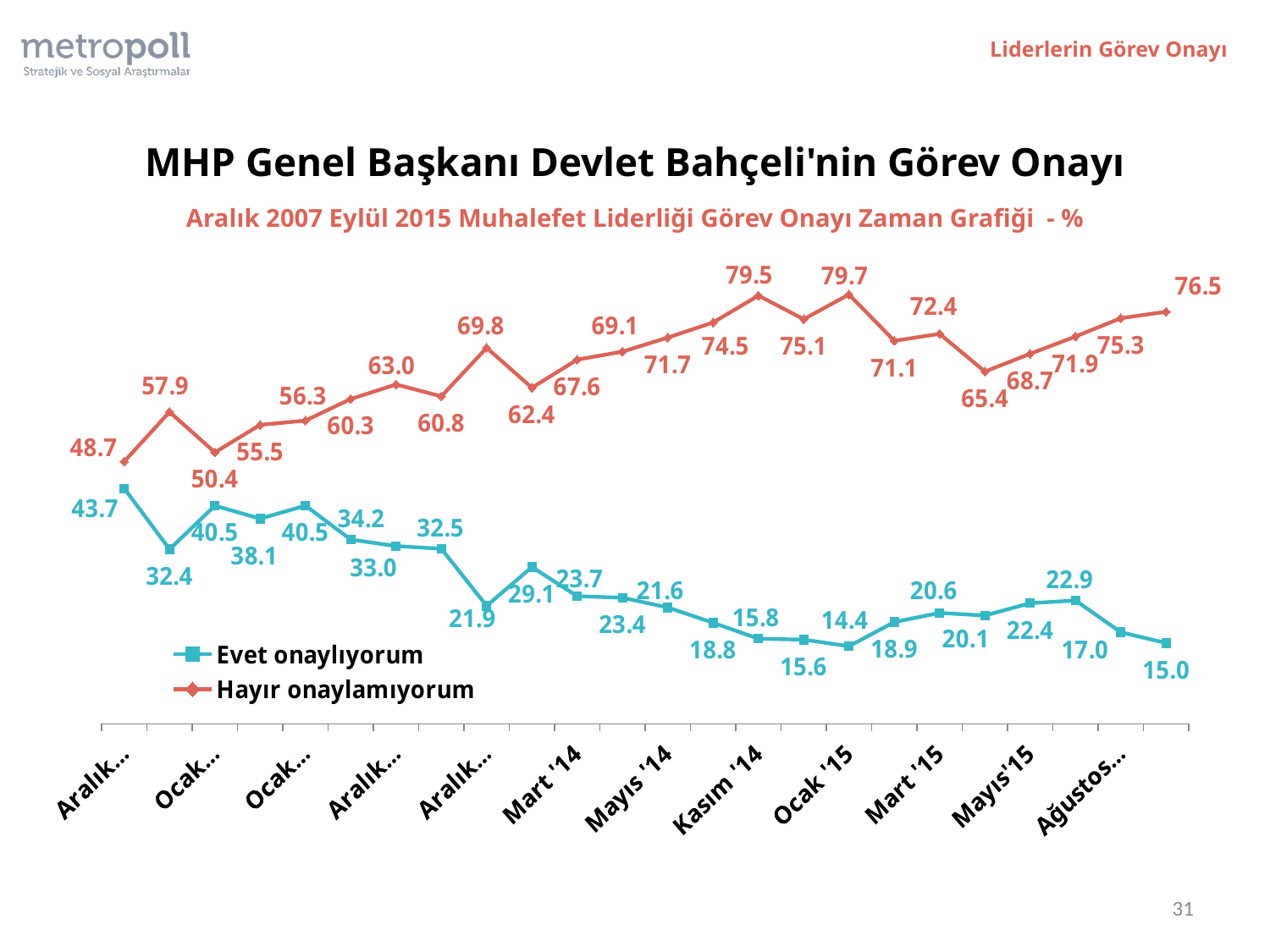
What are the two legend entries of the chart? Evet onaylıyorum; Hayır onaylamıyorum At which labelled date does 'Evet onaylıyorum' reach its lowest value? Ocak '15 How many data points does each series have? 24 At which labelled date does 'Hayır onaylamıyorum' reach its highest value? Ocak '15 Is the value of 'Evet onaylıyorum' higher at Mayıs'15 or at Mart '15? Mayıs'15 What is the value of 'Hayır onaylamıyorum' at Kasım '14? 79.5 How many series does the legend list? 2 What type of chart is shown on the slide? Line chart Does the 'Evet onaylıyorum' series generally rise or fall from left to right? Fall What is the value of 'Hayır onaylamıyorum' at Mart '15? 72.4 What is the difference between 'Hayır onaylamıyorum' and 'Evet onaylıyorum' at Mart '15? 51.8 What is the value of 'Evet onaylıyorum' at Ocak '15? 14.4